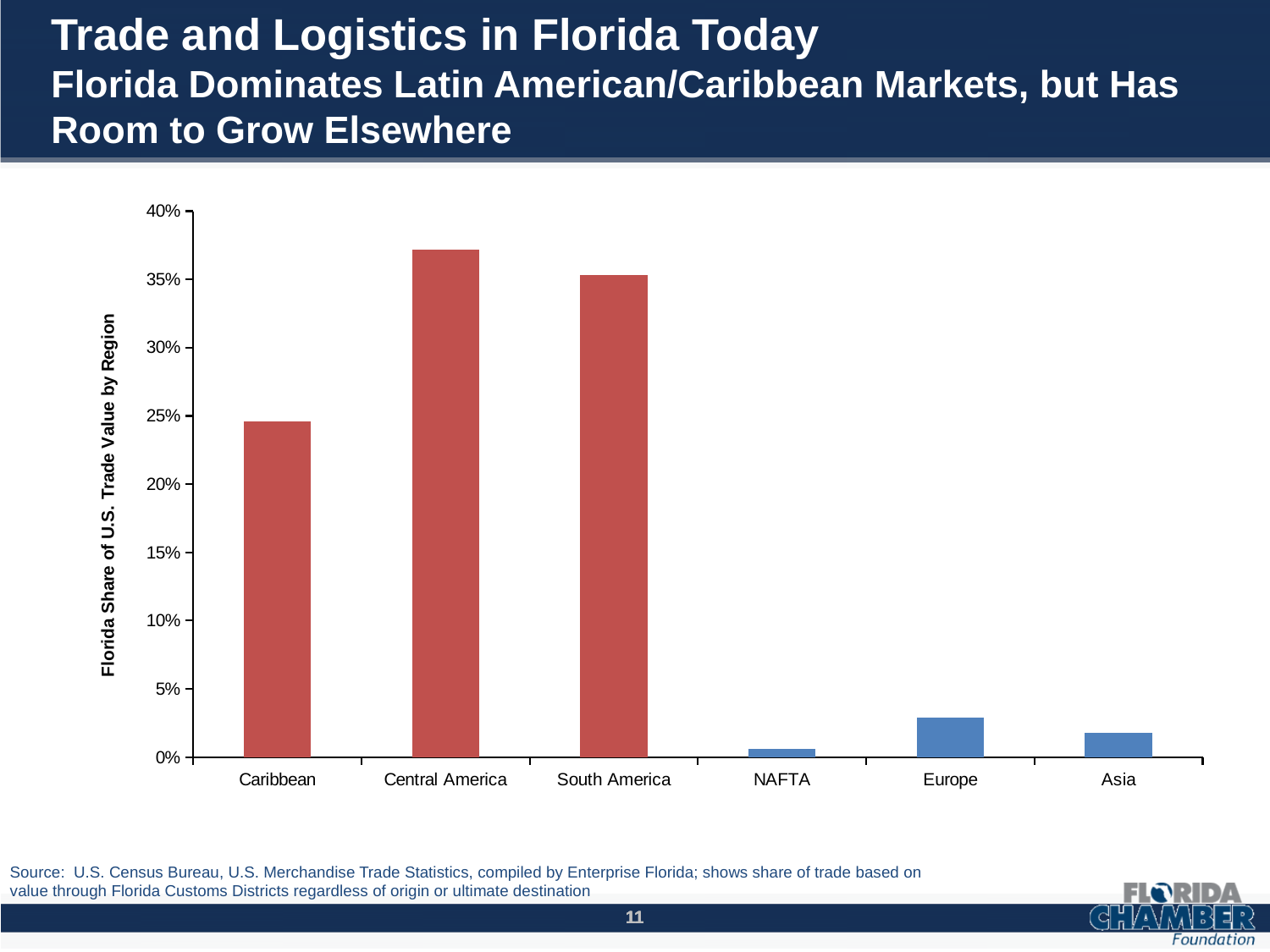
Which region has the highest Florida share of U.S. trade value? Central America Is the value for Asia greater or less than 5%? less What is the label on the vertical axis of the chart? Florida Share of U.S. Trade Value by Region Is the value for South America greater or less than 40%? less Which has a larger Florida share of U.S. trade value, Caribbean or South America? South America What kind of chart is shown on the slide? bar chart Is the value for Central America greater or less than 35%? greater Which region has the lowest Florida share of U.S. trade value? NAFTA Which has a larger Florida share of U.S. trade value, Europe or Asia? Europe How many regions are shown on the x axis of the chart? 6